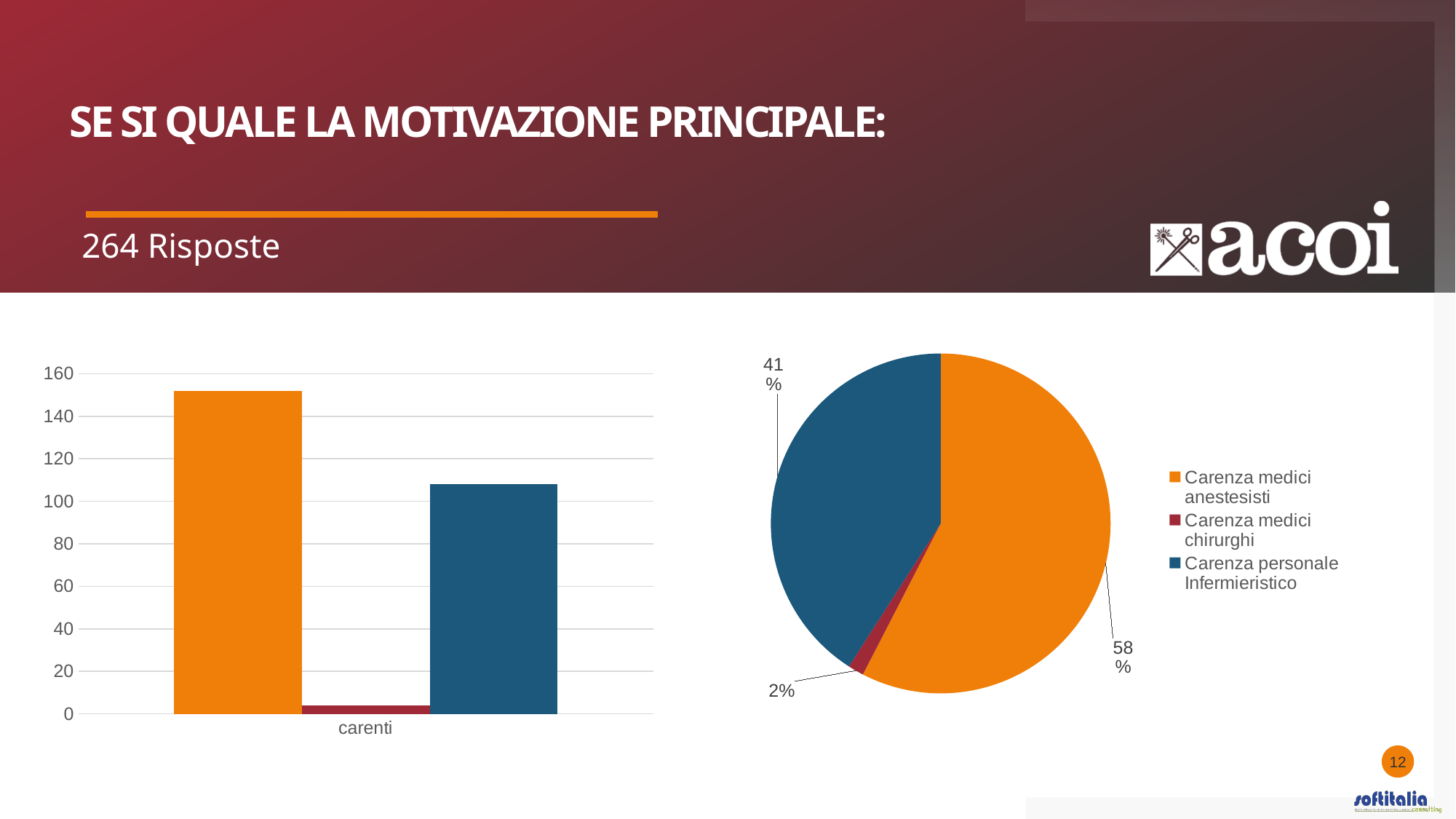
In the pie chart on the right, how many entries does the legend list? 3 In the pie chart on the right, what share is shown for Carenza medici anestesisti? 58% In the pie chart on the right, what share is shown for Carenza personale Infermieristico? 41% In the bar chart on the left, which is larger, the orange bar or the blue bar? The orange bar What kind of chart is the chart on the left of the slide? Bar chart In the pie chart on the right, how many slices does the pie have? 3 In the pie chart on the right, what share is shown for Carenza medici chirurghi? 2% In the bar chart on the left, is the value of the red bar greater or less than 20? less In the pie chart on the right, which category has the largest slice? Carenza medici anestesisti In the pie chart on the right, by how many percentage points does the Carenza medici anestesisti slice exceed the Carenza personale Infermieristico slice? 17 percentage points In the bar chart on the left, is the value of the orange bar greater or less than 140? greater In the pie chart on the right, which category has the smallest slice? Carenza medici chirurghi